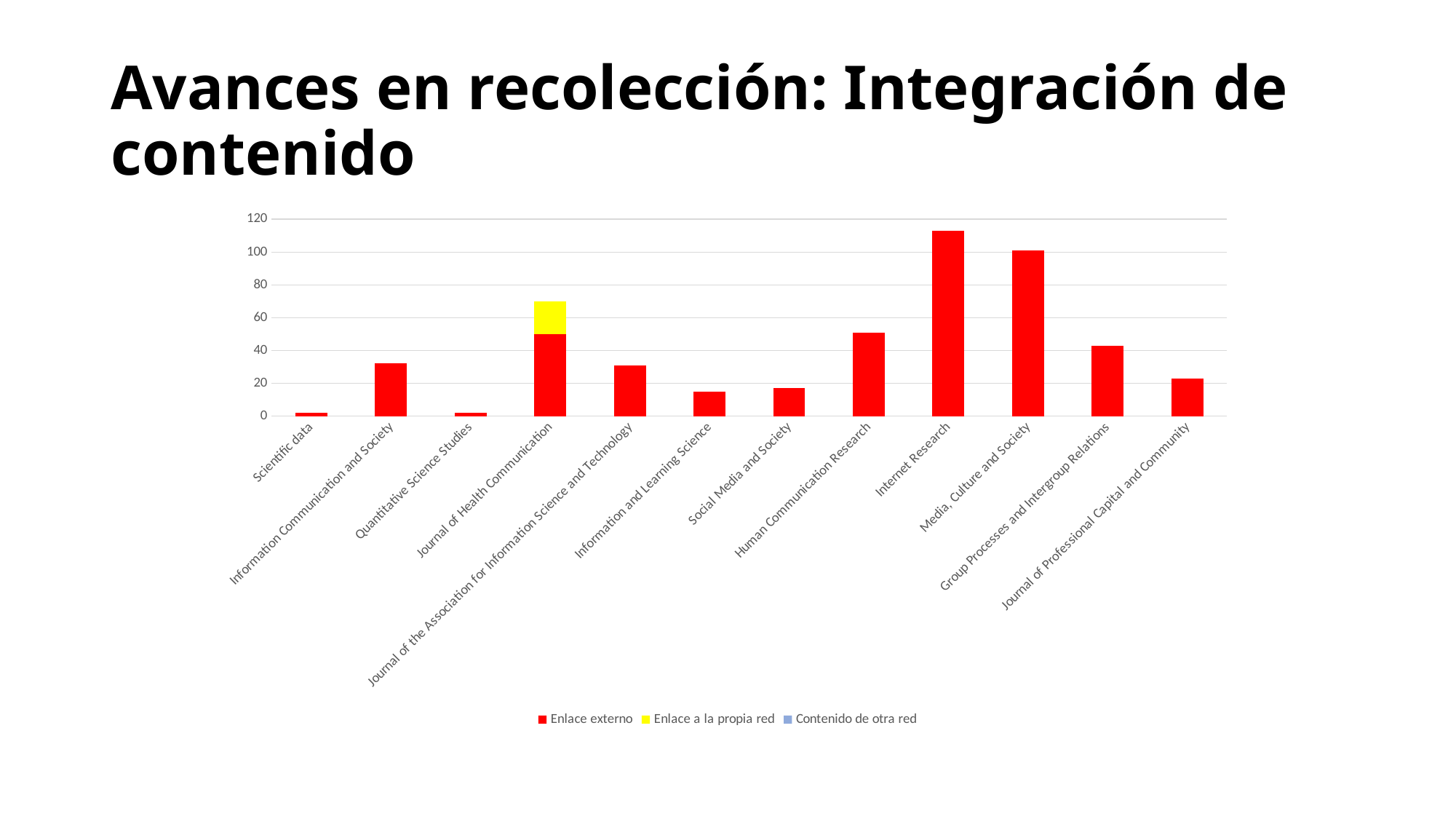
How many series does the chart's legend list? 3 Which bar is taller: Internet Research or Media, Culture and Society? Internet Research Is the value for Human Communication Research greater or less than 40? greater Is the value for Information and Learning Science greater or less than 20? less Is the value for Internet Research greater or less than 100? greater Which journal's bar includes a yellow 'Enlace a la propia red' segment? Journal of Health Communication Which bar is taller: Human Communication Research or Information Communication and Society? Human Communication Research What kind of chart is shown on the slide? bar chart What are the three series names listed in the chart's legend? Enlace externo, Enlace a la propia red, Contenido de otra red Which journal has the highest bar in the chart? Internet Research How many categories (journals) are shown on the x axis of the chart? 12